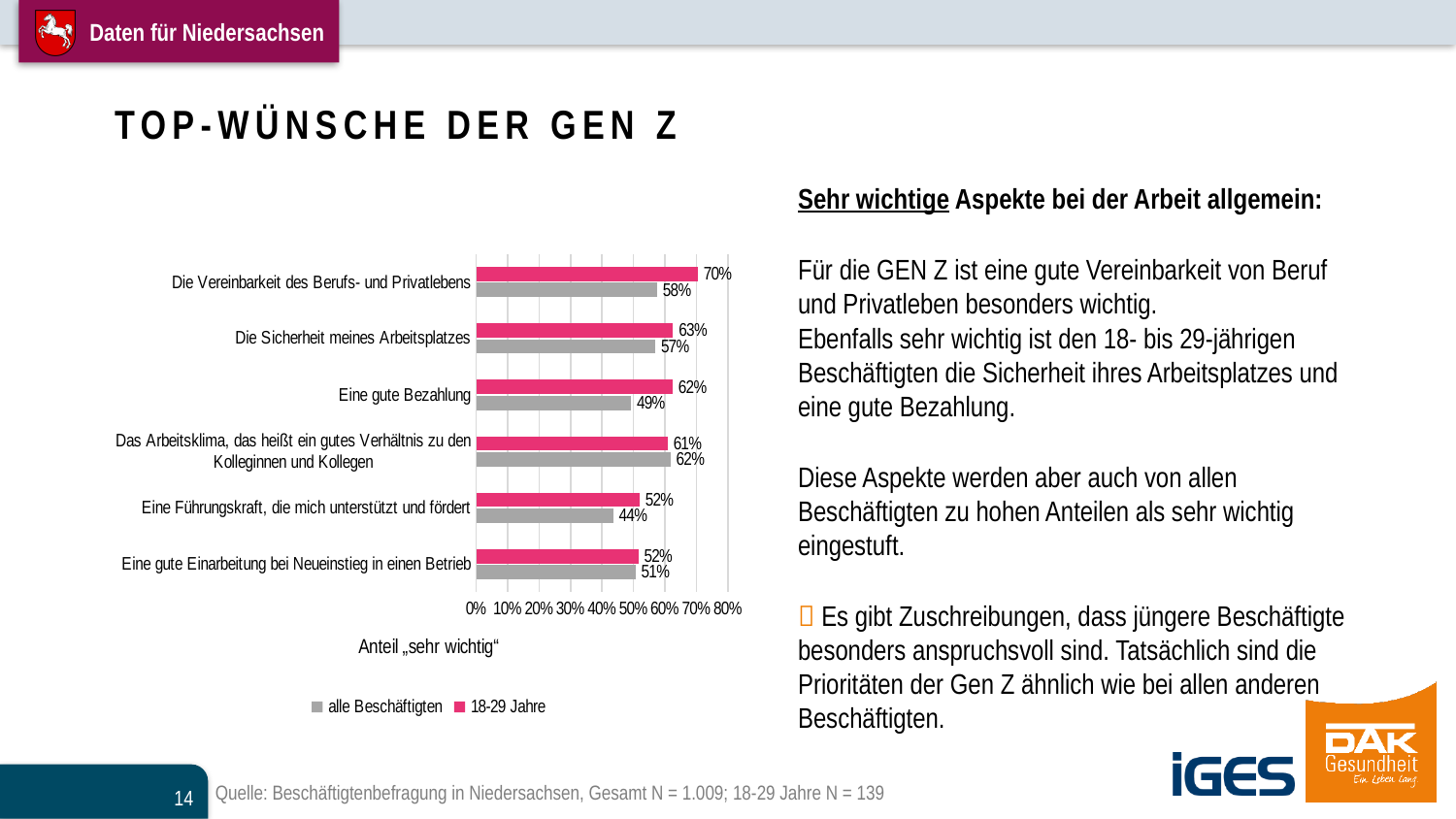
For "Das Arbeitsklima, das heißt ein gutes Verhältnis zu den Kolleginnen und Kollegen", which series has the larger value: "alle Beschäftigten" or "18-29 Jahre"? alle Beschäftigten What is the difference between the "18-29 Jahre" and "alle Beschäftigten" values for "Eine gute Bezahlung"? 13 percentage points What is the label of the x axis of the chart? Anteil "sehr wichtig" Which category has the lowest value for the "alle Beschäftigten" series? Eine Führungskraft, die mich unterstützt und fördert How many categories are shown in the chart? 6 What is the value for "alle Beschäftigten" for "Eine gute Bezahlung"? 49% How many series does the legend list? 2 What is the value for "18-29 Jahre" for "Die Vereinbarkeit des Berufs- und Privatlebens"? 70% Which category has the highest value for the "18-29 Jahre" series? Die Vereinbarkeit des Berufs- und Privatlebens What kind of chart is shown on the slide? Bar chart What is the value for "alle Beschäftigten" for "Eine Führungskraft, die mich unterstützt und fördert"? 44% Is the value for "18-29 Jahre" for "Die Sicherheit meines Arbeitsplatzes" greater or less than 60%? greater